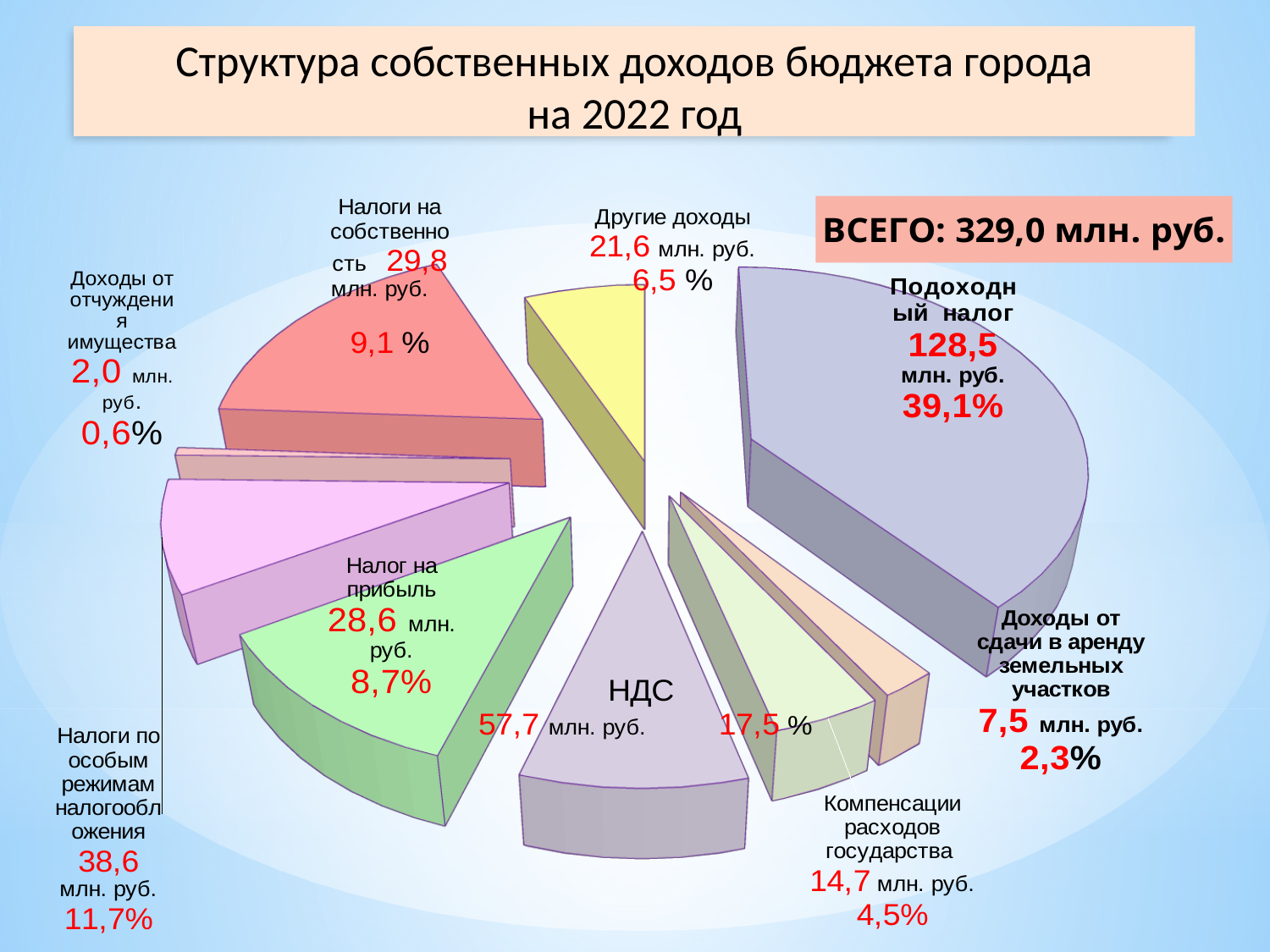
Which category has the largest slice of the pie? Подоходный налог Which is larger: Налоги на собственность or Налог на прибыль? Налоги на собственность What type of chart is shown on the slide? pie chart What is the total value of all categories shown on the slide? 329,0 млн. руб. What is the title of the slide? Структура собственных доходов бюджета города на 2022 год What share of the pie does НДС represent? 17,5 % What share of the pie does Компенсации расходов государства represent? 4,5% What is the value for Подоходный налог? 128,5 млн. руб. What is the value for Налог на прибыль? 28,6 млн. руб. Which category has the smallest slice of the pie? Доходы от отчуждения имущества How many categories are shown in the pie chart? 9 What is the difference in млн. руб. between Подоходный налог and НДС? 70,8 млн. руб.